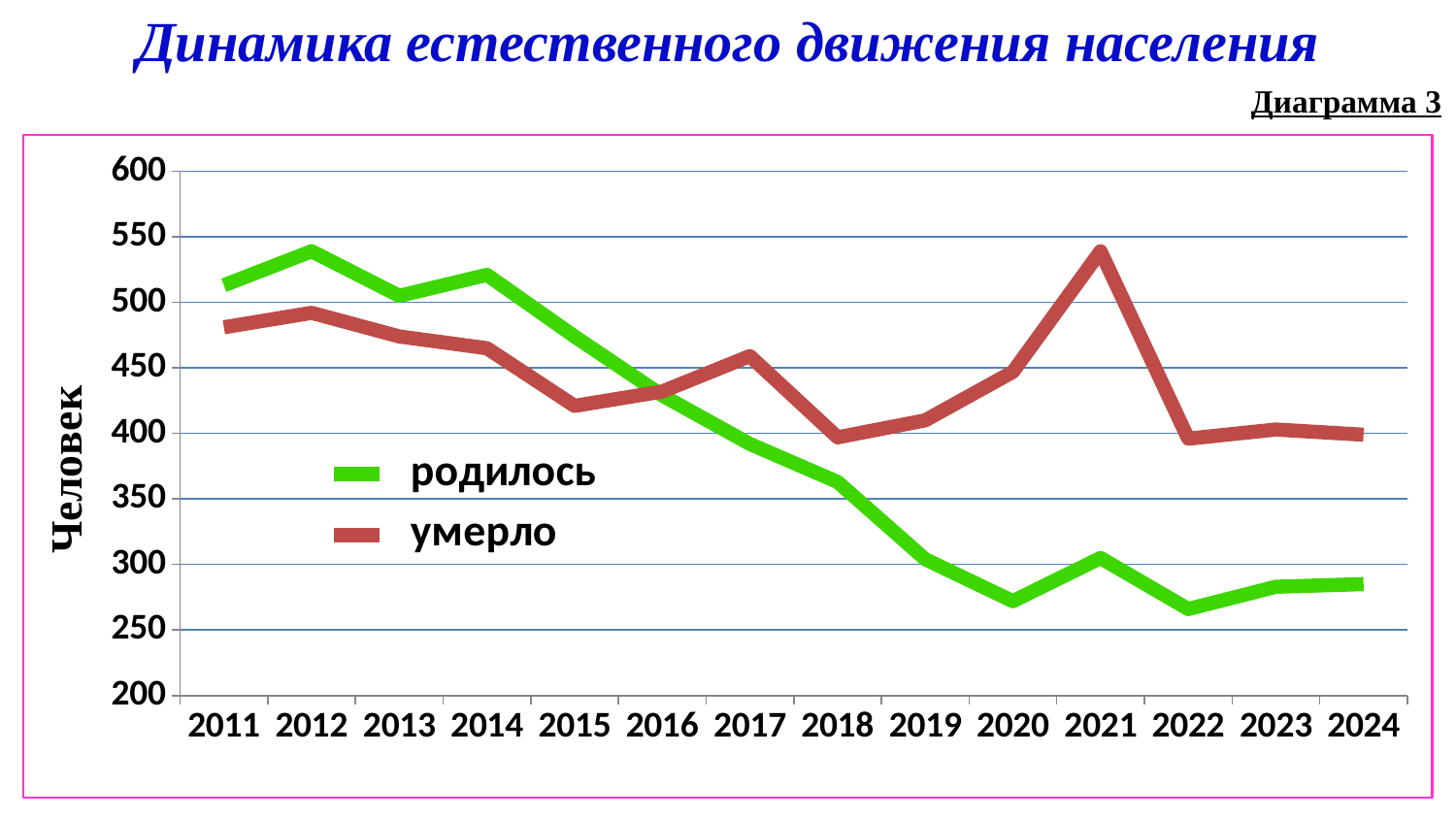
How many series does the legend list? 2 Is the value for родилось in 2020 greater or less than 300? less How many years are shown on the x axis? 14 In 2011, which series has the larger value, родилось or умерло? родилось Is the value for умерло in 2015 greater or less than 400? greater In which year is the value for умерло highest? 2021 Is the value for умерло in 2021 greater or less than 500? greater In 2024, which series has the larger value, родилось or умерло? умерло Does the value for родилось generally rise or fall from 2011 to 2024? fall What kind of chart is shown on the slide? line chart In which year is the value for родилось highest? 2012